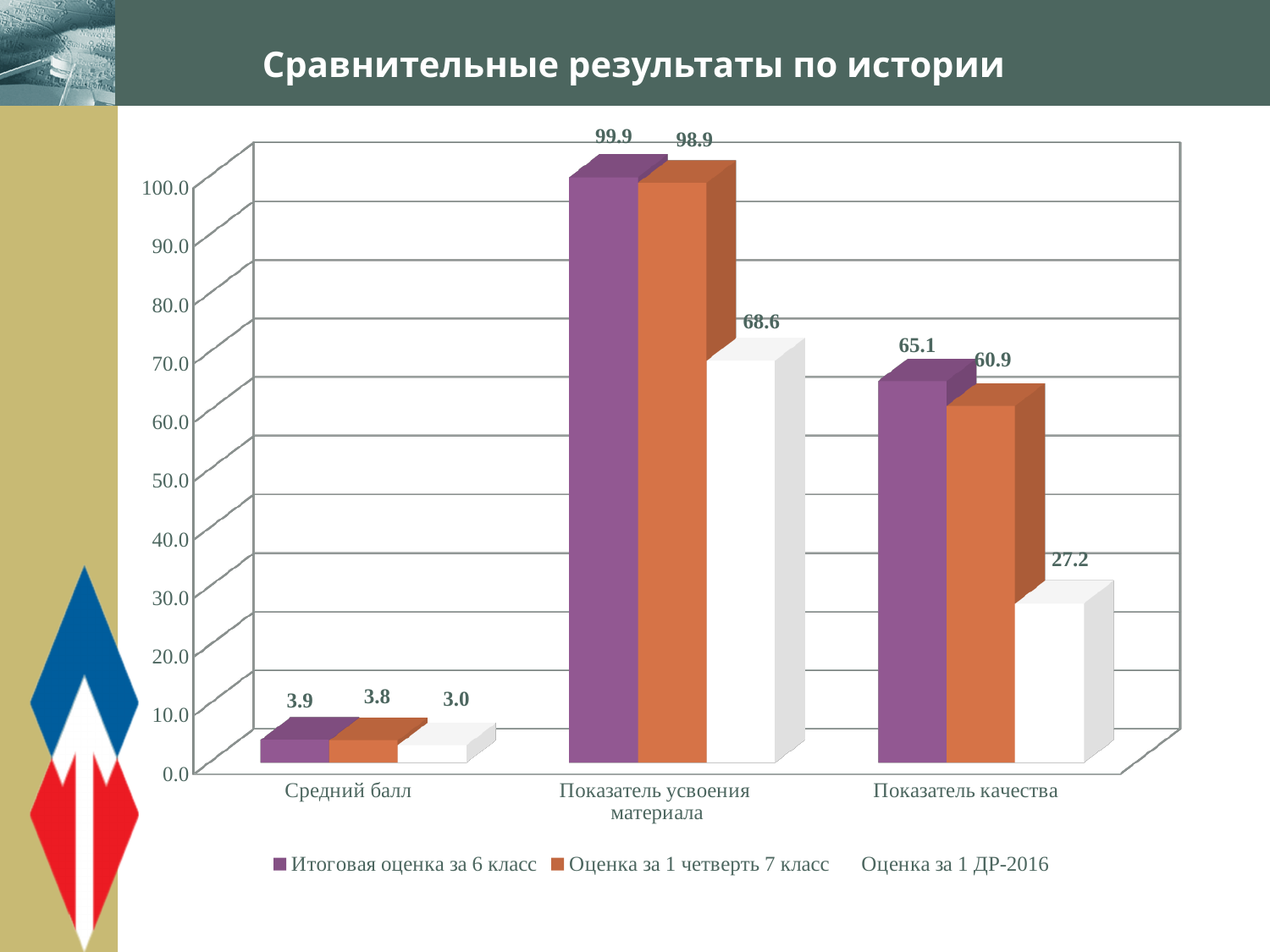
Is the value of 'Оценка за 1 ДР-2016' for 'Показатель усвоения материала' greater or less than 60.0? greater How many categories are shown on the x axis? 3 Which category has the lowest value for 'Итоговая оценка за 6 класс'? Средний балл What is the value of 'Оценка за 1 ДР-2016' for 'Показатель качества'? 27.2 What kind of chart is shown on the slide? bar chart What is the value of 'Итоговая оценка за 6 класс' for 'Показатель усвоения материала'? 99.9 What is the difference between 'Оценка за 1 четверть 7 класс' and 'Оценка за 1 ДР-2016' for 'Показатель качества'? 33.7 What is the title of the slide? Сравнительные результаты по истории Which is larger for 'Показатель усвоения материала': 'Итоговая оценка за 6 класс' or 'Оценка за 1 ДР-2016'? Итоговая оценка за 6 класс Which category has the highest value for 'Оценка за 1 ДР-2016'? Показатель усвоения материала What is the value of 'Оценка за 1 четверть 7 класс' for 'Средний балл'? 3.8 How many series does the legend list? 3